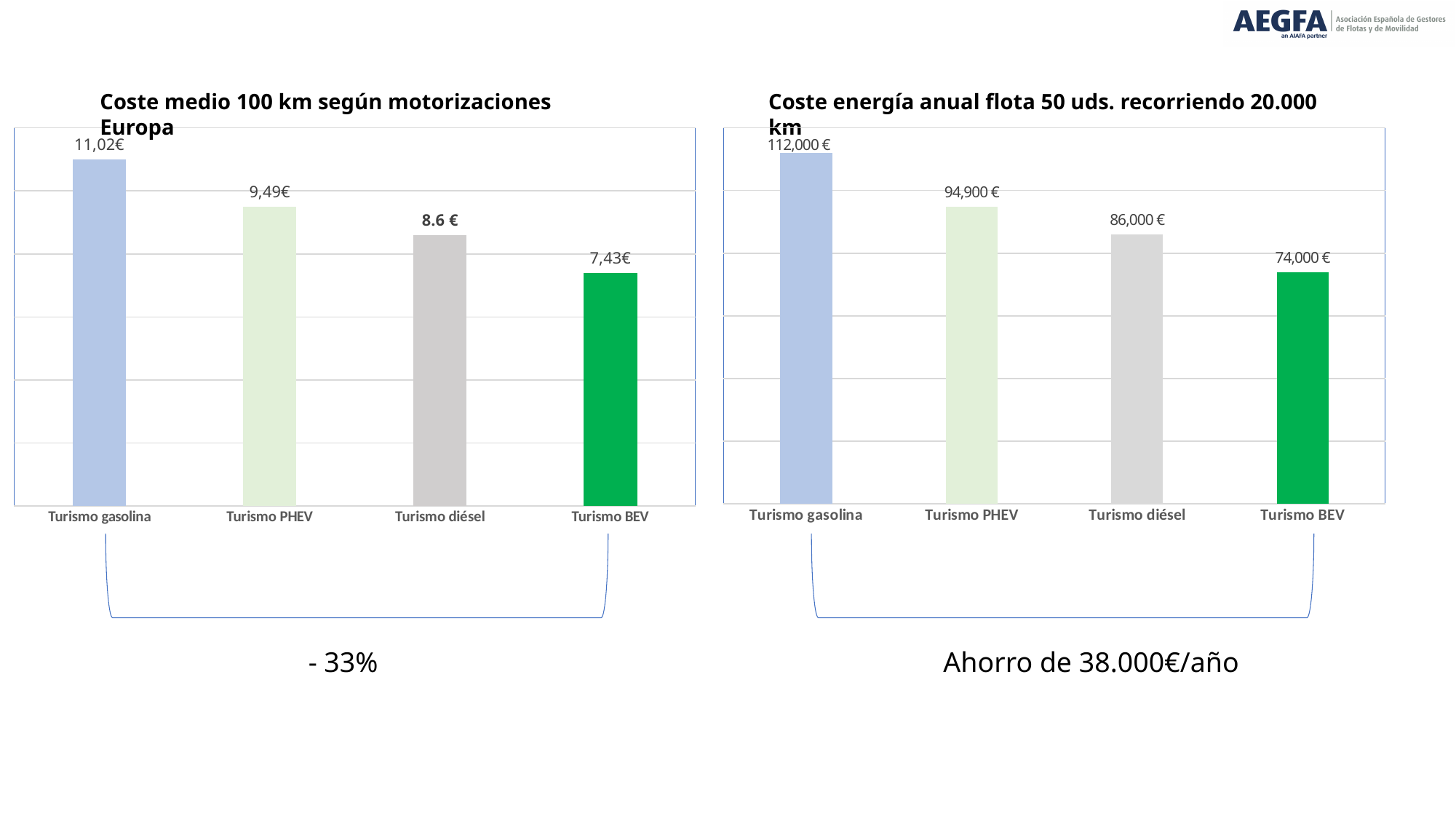
In the right chart (Coste energía anual flota 50 uds. recorriendo 20.000 km), what is the value for Turismo PHEV? 94,900 € In the left chart (Coste medio 100 km según motorizaciones Europa), what is the value for Turismo gasolina? 11,02€ In the right chart (Coste energía anual flota 50 uds. recorriendo 20.000 km), what is the difference between Turismo gasolina and Turismo BEV? 38,000 € In the left chart (Coste medio 100 km según motorizaciones Europa), which category has the lowest value? Turismo BEV In the left chart (Coste medio 100 km según motorizaciones Europa), what is the value for Turismo diésel? 8.6 € What kind of chart is the left chart (Coste medio 100 km según motorizaciones Europa)? bar chart In the left chart (Coste medio 100 km según motorizaciones Europa), what is the difference between Turismo gasolina and Turismo BEV? 3,59€ In the right chart (Coste energía anual flota 50 uds. recorriendo 20.000 km), which is larger: Turismo PHEV or Turismo diésel? Turismo PHEV In the right chart (Coste energía anual flota 50 uds. recorriendo 20.000 km), which category has the highest value? Turismo gasolina In the left chart (Coste medio 100 km según motorizaciones Europa), how many categories are shown? 4 In the right chart (Coste energía anual flota 50 uds. recorriendo 20.000 km), what is the value for Turismo BEV? 74,000 € In the right chart (Coste energía anual flota 50 uds. recorriendo 20.000 km), do the values rise or fall from left to right across the categories? fall